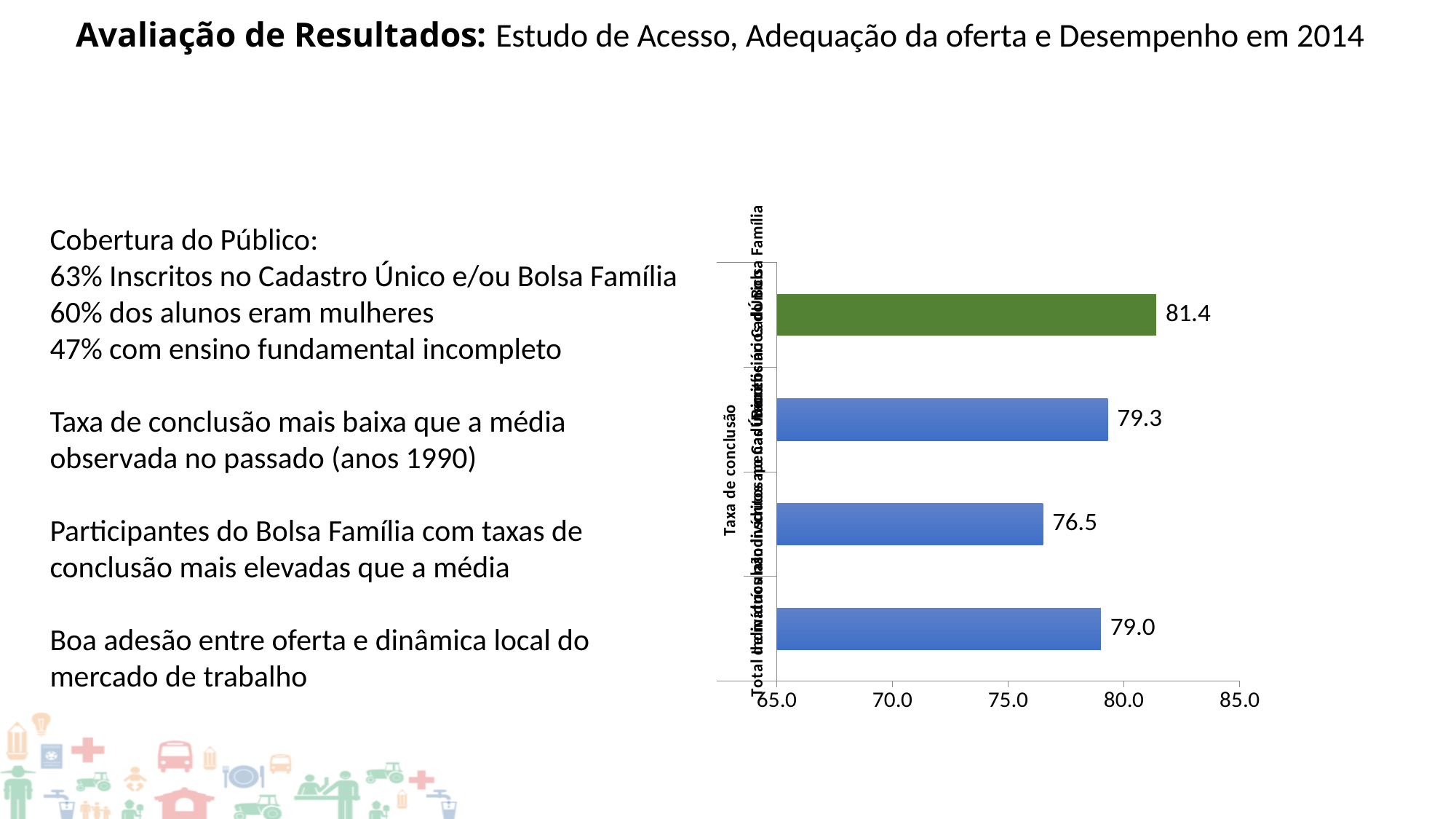
Which is larger: the value of the second bar from the top or the value of the bottom bar? the second bar from the top (79.3) What is the difference between the top bar's value (81.4) and the third bar's value (76.5)? 4.9 How many bars are plotted in the chart? 4 What is the value shown on the second bar from the top of the chart? 79.3 Is the value of the third bar from the top greater or less than 80.0? less What is the value shown on the third bar from the top of the chart? 76.5 Which bar has the highest value in the chart? the green top bar (81.4) What is the value shown on the bottom bar of the chart? 79.0 What is the title of the vertical axis of the chart? Taxa de conclusão What type of chart is shown on the slide? bar chart Which bar has the lowest value in the chart? the third bar from the top (76.5) What is the value shown on the green (top) bar of the chart? 81.4